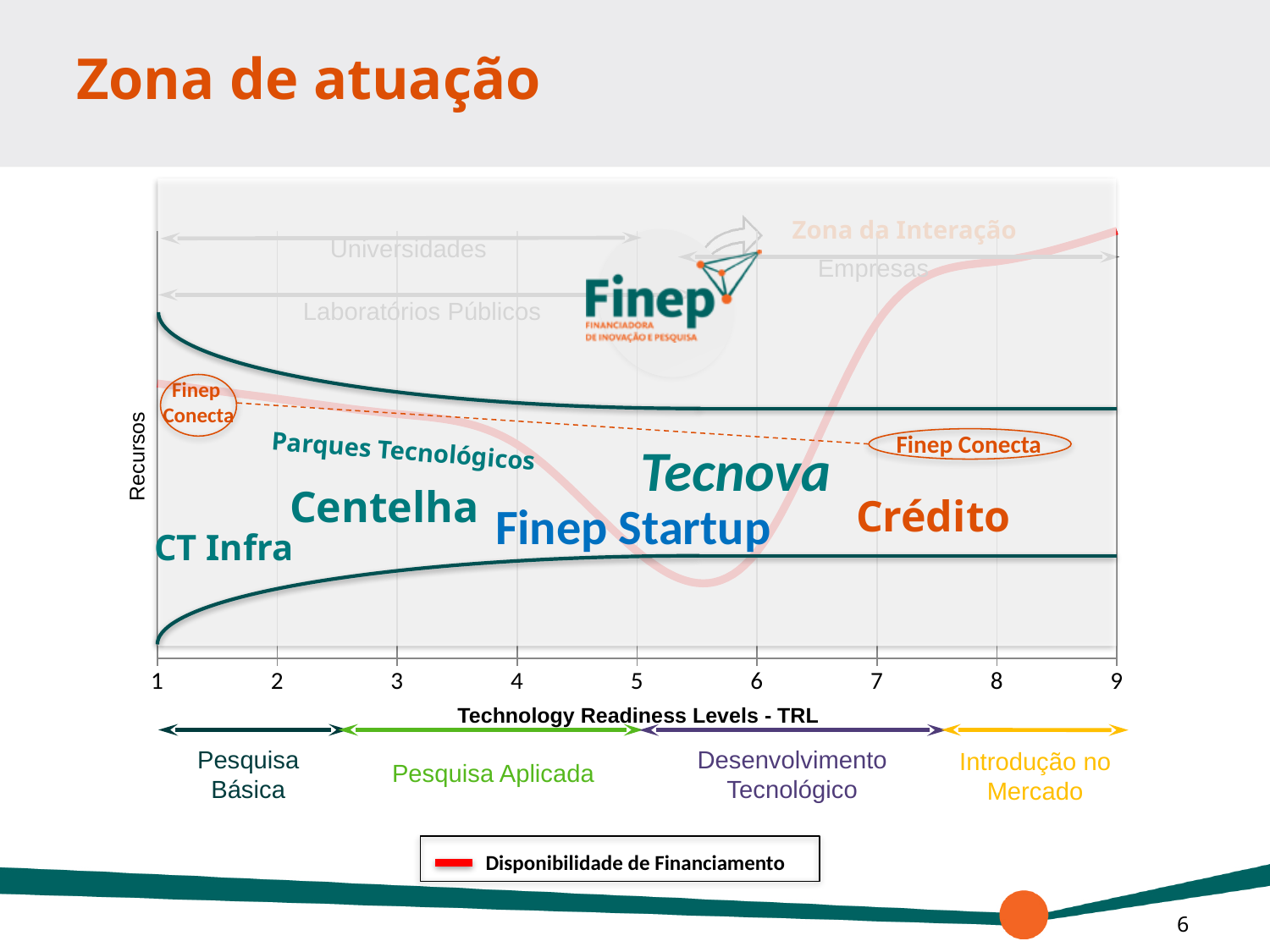
How many series does the chart's legend list? 1 What series name does the legend of the chart show? Disponibilidade de Financiamento What is the title of the x axis of the chart? Technology Readiness Levels - TRL What kind of chart is shown on the slide? line chart Does the Disponibilidade de Financiamento line rise or fall between TRL 6 and TRL 7? rise Does the Disponibilidade de Financiamento line rise or fall between TRL 1 and TRL 5? fall How many TRL levels are marked along the x axis of the chart? 9 Does the Disponibilidade de Financiamento line rise or fall between TRL 8 and TRL 9? rise